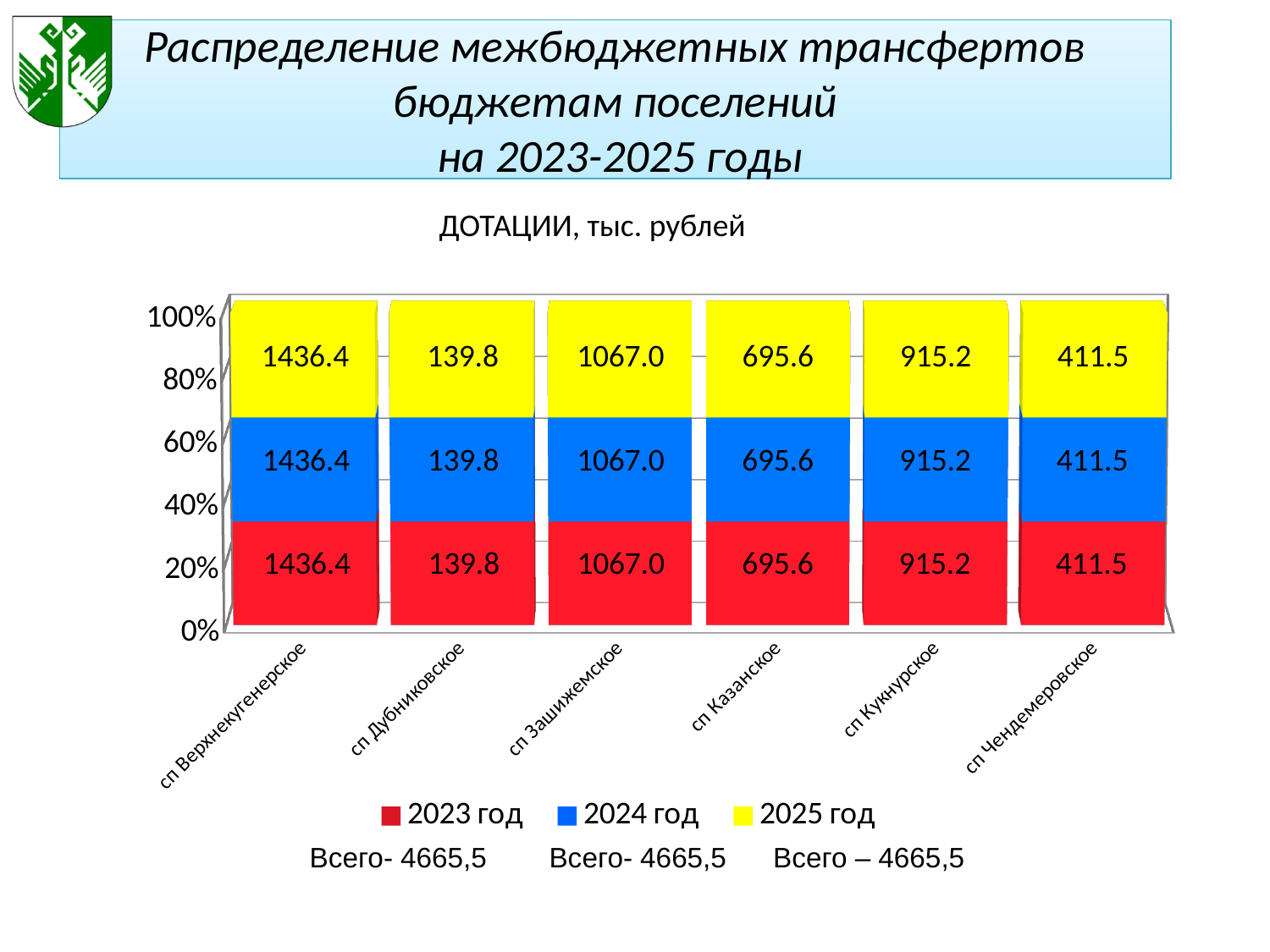
Which category has the lowest value in the 2025 год series? сп Дубниковское What is the total of the three stacked values for сп Дубниковское? 419.4 What is the difference between the 2023 год values for сп Верхнекугенерское and сп Дубниковское? 1296.6 How many series does the legend list? 3 What is the value for сп Чендемеровское in the 2025 год series? 411.5 What is the value for сп Верхнекугенерское in the 2023 год series? 1436.4 Which is larger: the 2025 год value for сп Кукнурское or for сп Чендемеровское? сп Кукнурское What kind of chart is shown on the slide? Stacked bar chart Which category has the highest value in the 2023 год series? сп Верхнекугенерское What is the difference between the 2024 год values for сп Зашижемское and сп Казанское? 371.4 What is the value for сп Казанское in the 2024 год series? 695.6 How many categories are shown on the x axis? 6